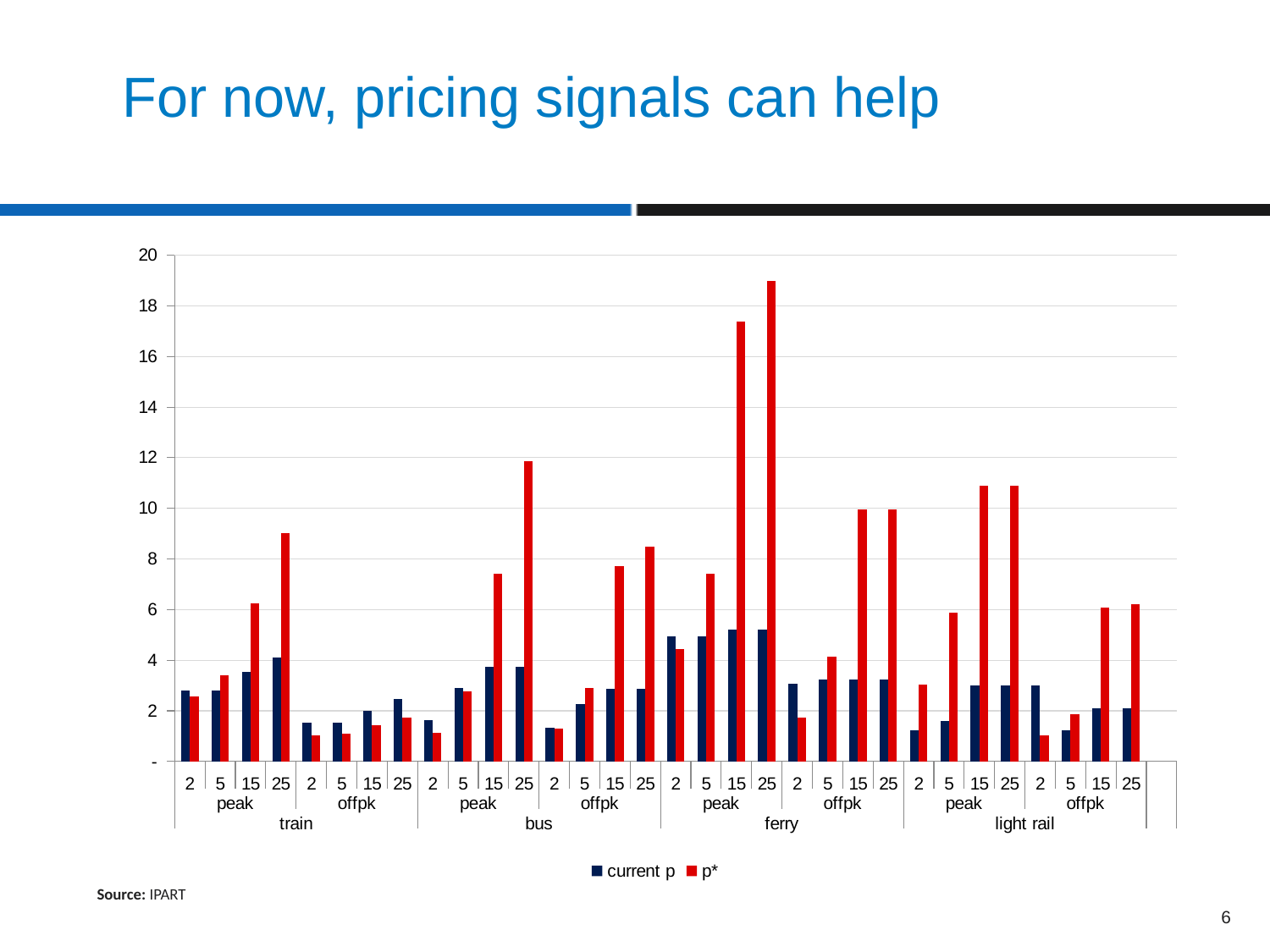
Which is larger: the p* value for ferry peak 15 or the p* value for bus peak 25? ferry peak 15 Is the p* value for bus peak 25 greater or less than 10? greater How many transport modes are shown along the x axis? 4 Is the p* value for train offpk 5 greater or less than 2? less Is the p* value for train peak 25 greater or less than 8? greater What are the names of the two series in the legend? current p and p* For which category is the p* bar highest? ferry peak 25 Which colour represents the p* series? red Within the train peak group, do the p* values rise or fall as distance increases from 2 to 25? rise How many series does the legend list? 2 What kind of chart is shown on the slide? bar chart